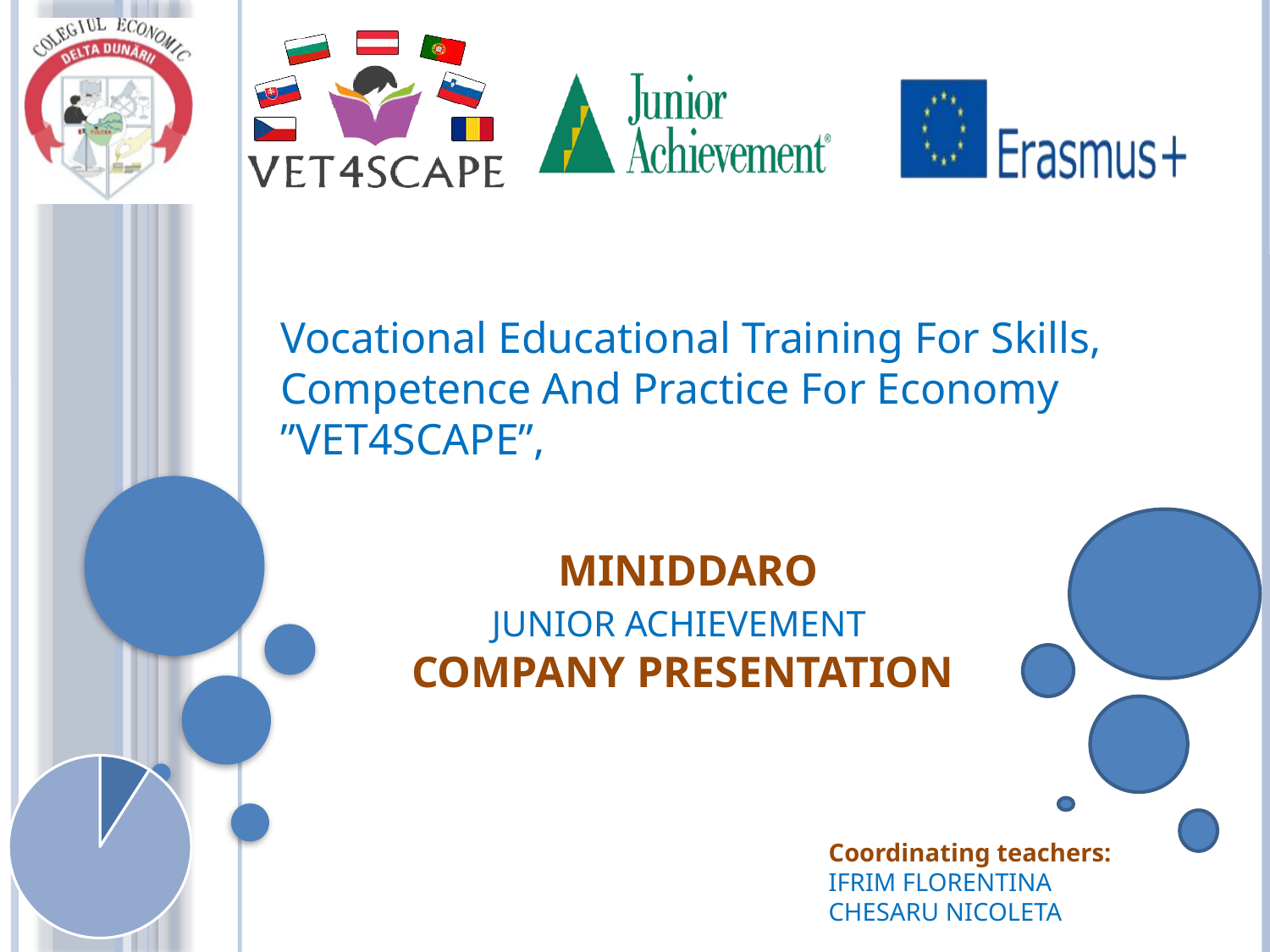
In the pie chart in the bottom-left corner, which slice is larger, the dark blue one or the light blue one? the light blue one How many slices does the pie chart in the bottom-left corner have? 2 What kind of chart is shown in the bottom-left corner of the slide? pie chart Does the pie chart in the bottom-left corner have a legend? No